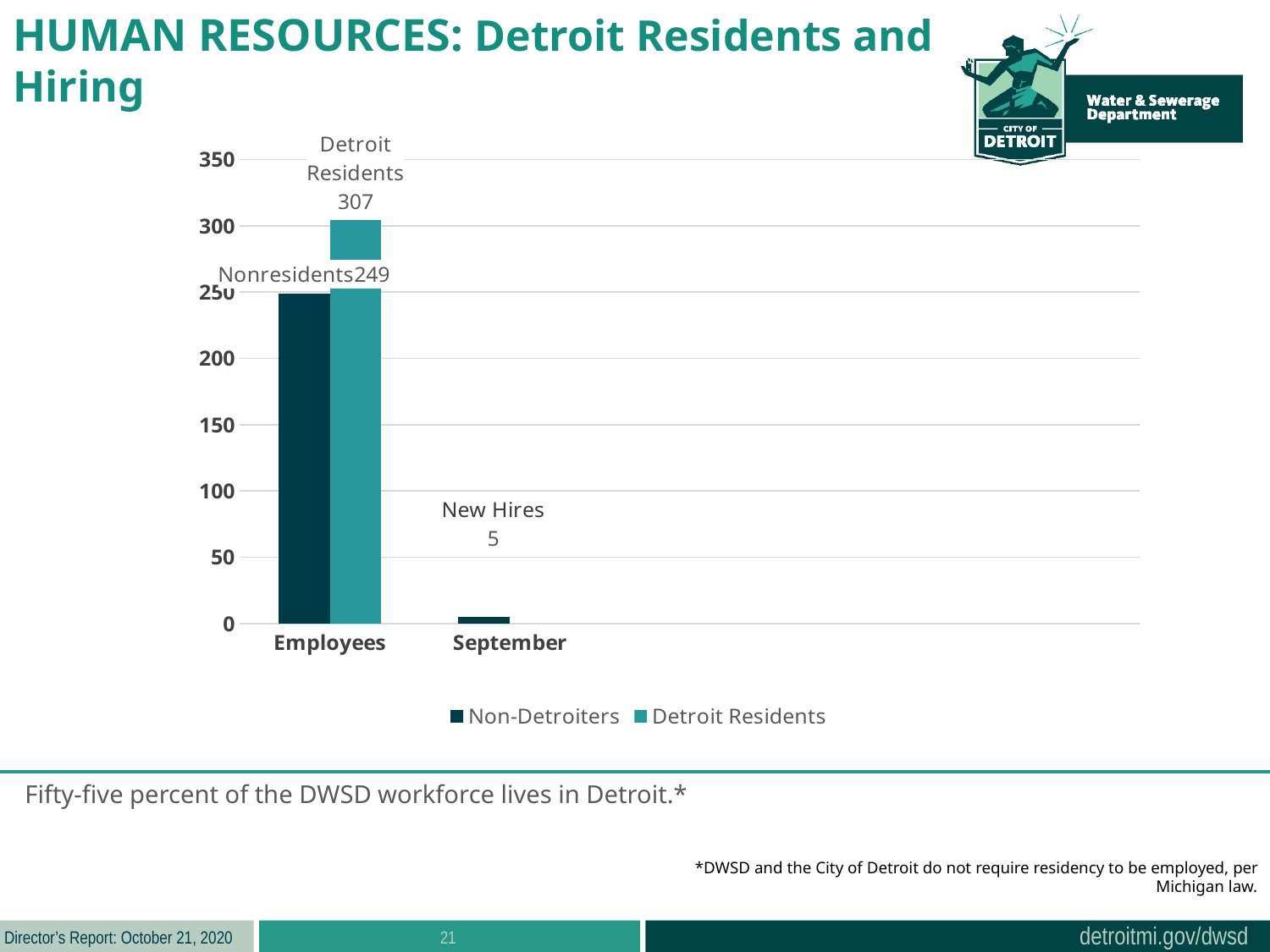
What are the two series named in the legend? Non-Detroiters and Detroit Residents Is the Detroit Residents value in the Employees category greater or less than 300? greater What is the value labelled for Nonresidents in the Employees category? 249 Which is larger in the Employees category, Detroit Residents or Nonresidents? Detroit Residents What kind of chart is shown on the slide? bar chart What is the difference between the Detroit Residents value (307) and the Nonresidents value (249) in the Employees category? 58 How many series does the legend list? 2 How many categories are shown on the x axis? 2 What is the value labelled for Detroit Residents in the Employees category? 307 Which category has the lowest bar on the chart? September Is the Nonresidents value in the Employees category greater or less than 250? less What is the value labelled for New Hires in the September category? 5